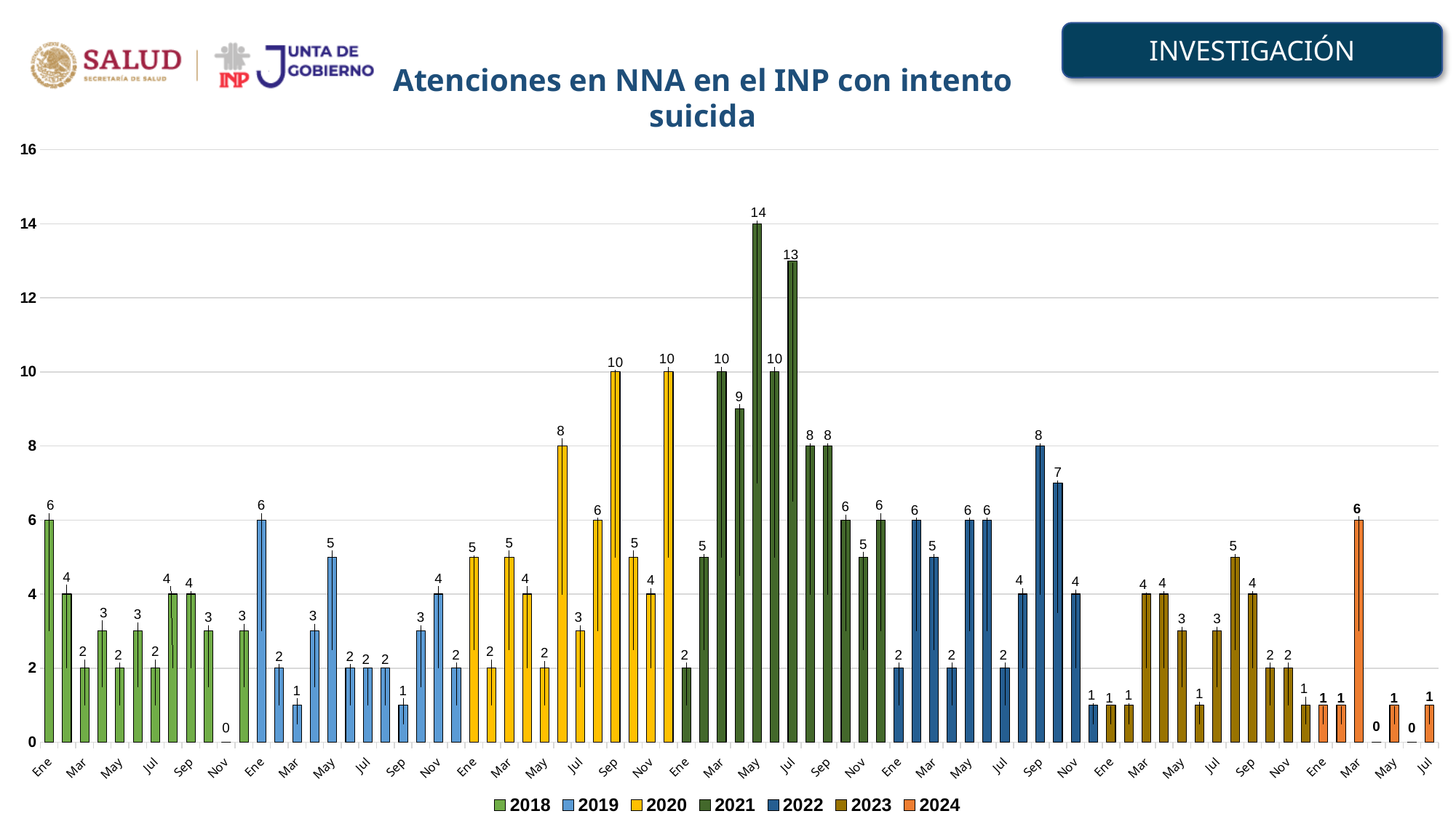
What is the value for Nov in the 2018 series? 0 Which is larger, the Sep value for 2022 or the Sep value for 2023? 2022 What kind of chart is shown on the slide? bar chart What is the value for Ene in the 2018 series? 6 What is the value for Jul in the 2021 series? 13 What is the difference between the Sep 2020 value and the Sep 2019 value? 9 What is the highest value shown in the chart, and in which month and year does it occur? 14, May 2021 How many series does the legend list? 7 What is the value for Sep in the 2020 series? 10 What is the difference between the May 2021 value and the Jul 2021 value? 1 What is the title of the chart? Atenciones en NNA en el INP con intento suicida What is the value for Mar in the 2024 series? 6